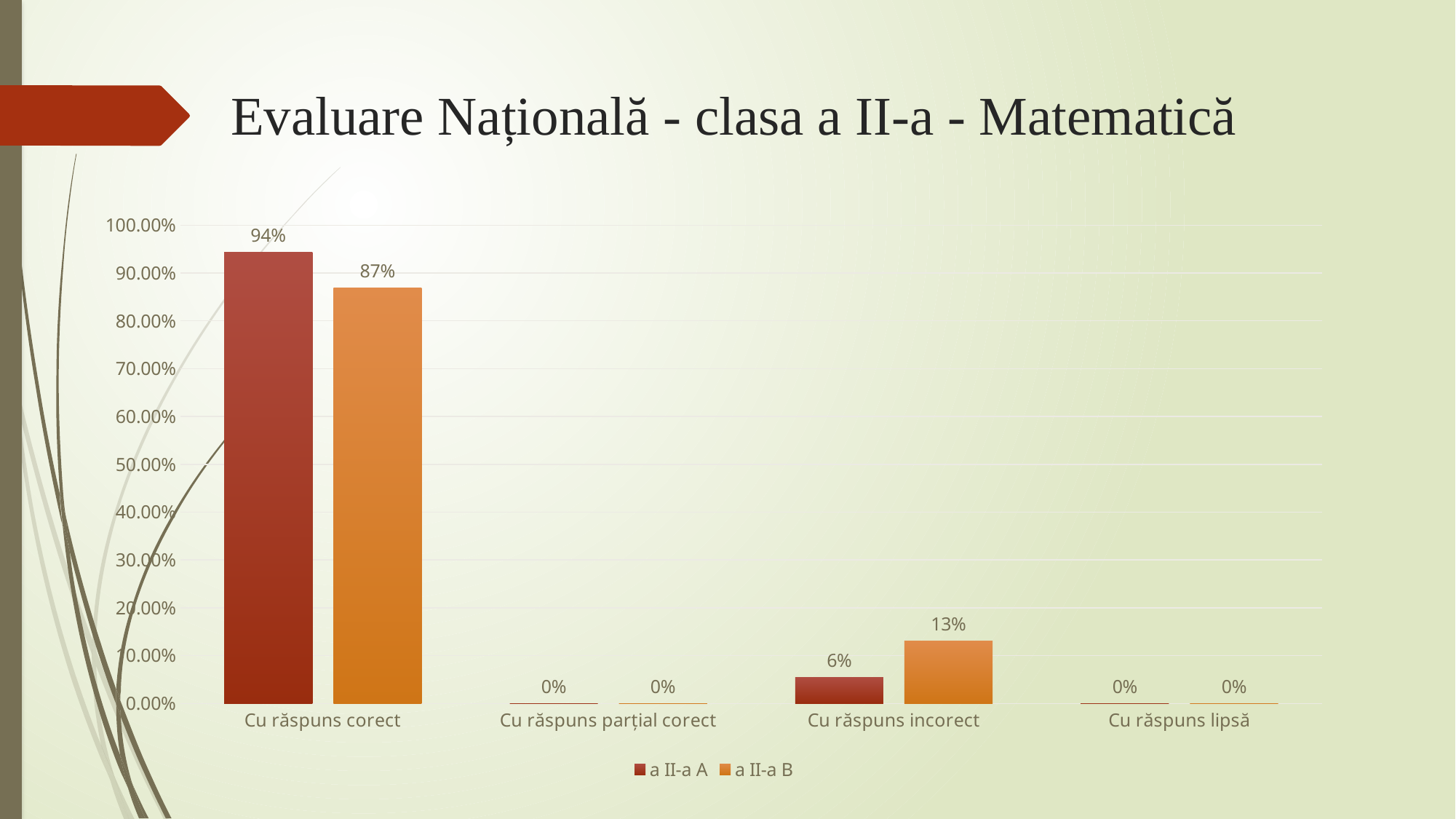
Which category has the highest value for a II-a B? Cu răspuns corect What is the value for a II-a A in the 'Cu răspuns corect' category? 94% Which series has the larger value in the 'Cu răspuns incorect' category, a II-a A or a II-a B? a II-a B What is the difference between a II-a B and a II-a A in the 'Cu răspuns incorect' category? 7% What is the value for a II-a A in the 'Cu răspuns lipsă' category? 0% How many series does the legend list? 2 What is the value for a II-a B in the 'Cu răspuns incorect' category? 13% How many categories are shown on the x axis? 4 What is the value for a II-a A in the 'Cu răspuns incorect' category? 6% What is the difference between a II-a A and a II-a B in the 'Cu răspuns corect' category? 7% What is the value for a II-a B in the 'Cu răspuns corect' category? 87% What kind of chart is shown on the slide? Bar chart